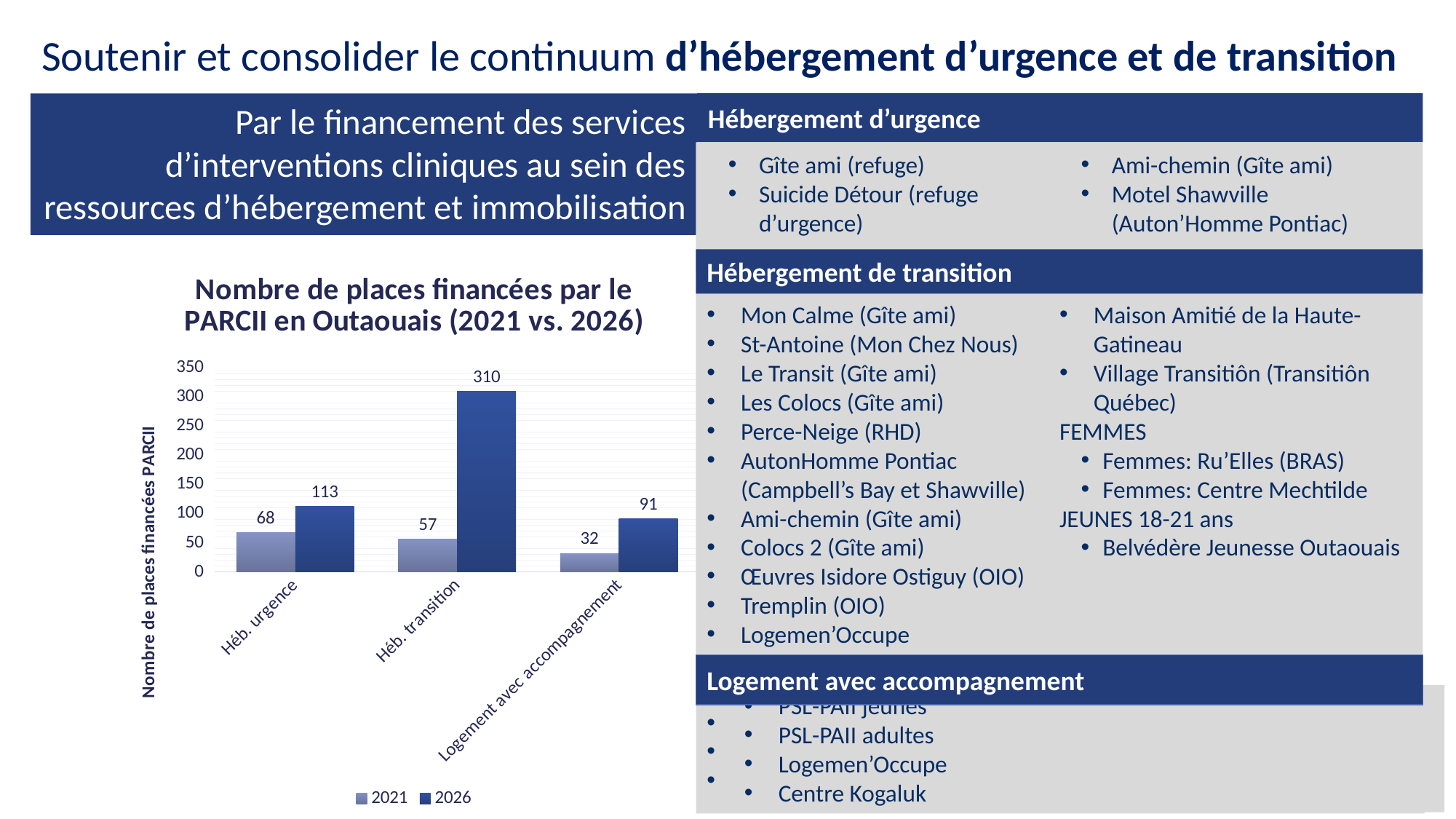
Which category has the lowest value in 2021? Logement avec accompagnement Which is larger: the 2021 value for Héb. urgence or the 2021 value for Héb. transition? Héb. urgence What is the title of the chart? Nombre de places financées par le PARCII en Outaouais (2021 vs. 2026) Which category has the highest value in 2026? Héb. transition What is the value for Logement avec accompagnement in 2021? 32 How many series does the legend list? 2 How many categories are shown on the x axis? 3 What kind of chart is shown on the slide? bar chart What is the difference between the 2026 and 2021 values for Héb. urgence? 45 What is the difference between the 2026 and 2021 values for Héb. transition? 253 What is the value for Héb. urgence in 2021? 68 What is the value for Héb. transition in 2026? 310